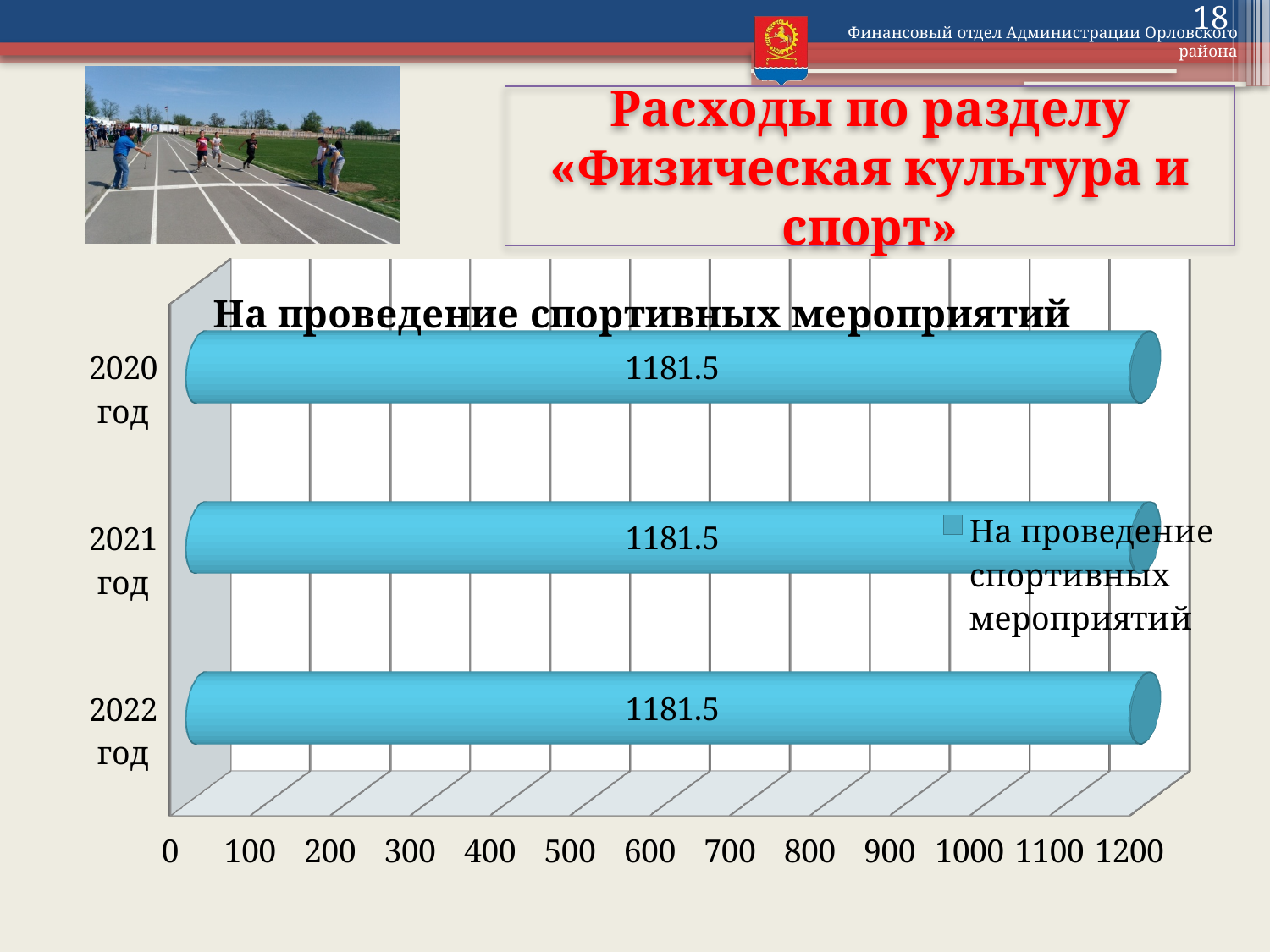
How many series does the legend list? 1 Do the values change from 2020 год to 2022 год? No, they stay the same How many categories (years) are shown on the chart? 3 What kind of chart is shown on the slide? bar chart What is the title of the chart? На проведение спортивных мероприятий What is the value for 2021 год? 1181.5 What is the difference between the values for 2020 год and 2022 год? 0 What is the value for 2020 год? 1181.5 Is the value for 2021 год greater or less than 1100? greater Is the value for 2022 год greater or less than 1200? less What is the highest value shown on the horizontal axis? 1200 What is the value for 2022 год? 1181.5